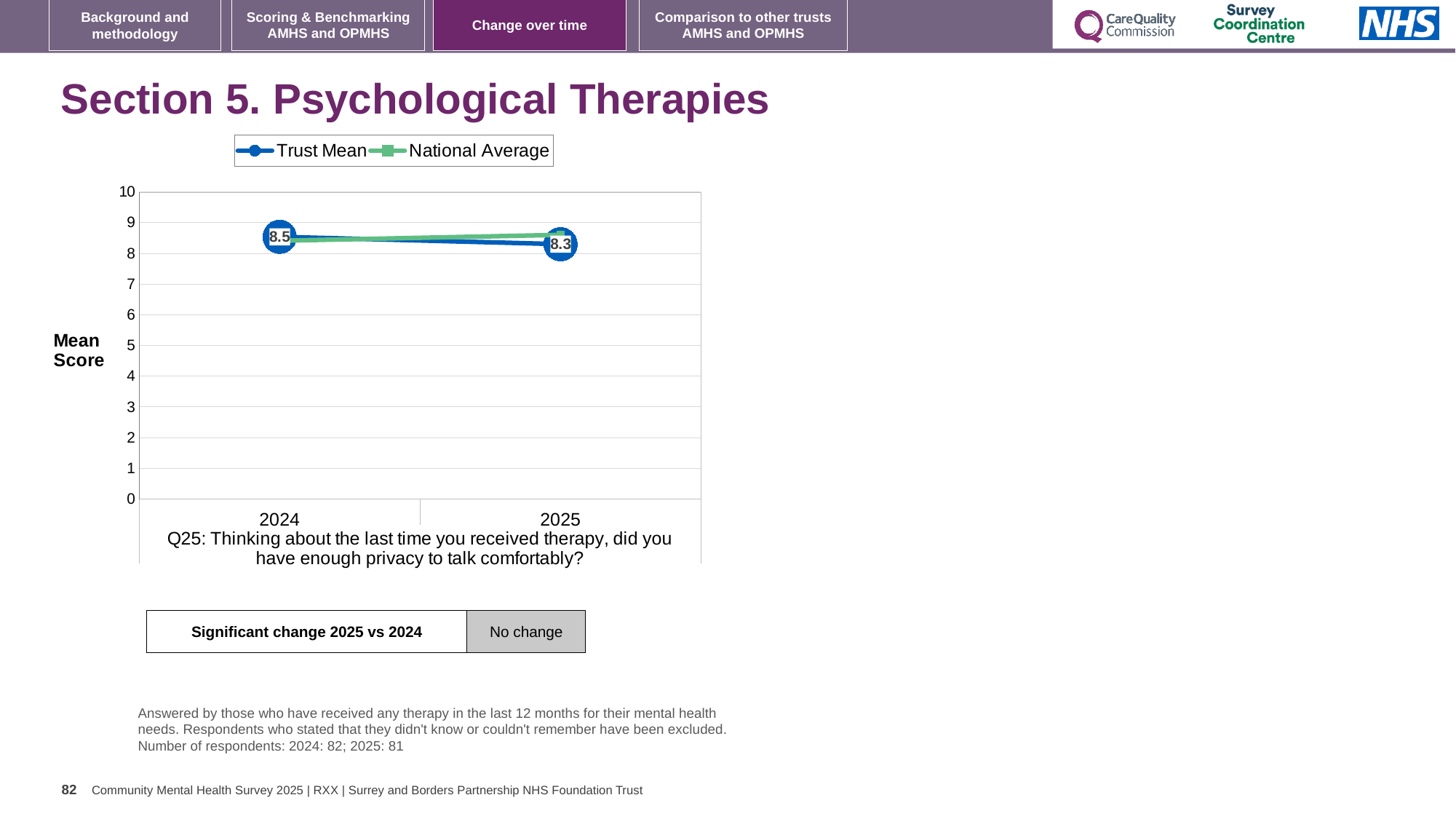
In which year is the Trust Mean at its lowest? 2025 How many series does the legend list? 2 What is the Trust Mean value for 2024? 8.5 Is the National Average value for 2025 greater or less than 8? greater Which year has the higher Trust Mean, 2024 or 2025? 2024 What is the Trust Mean value for 2025? 8.3 Is the National Average value for 2024 greater or less than 7? greater By how much did the Trust Mean change from 2024 to 2025? 0.2 How many years are plotted on the x axis? 2 What is the label on the y axis of the chart? Mean Score Does the Trust Mean rise or fall from 2024 to 2025? fall What kind of chart is shown on the slide? line chart